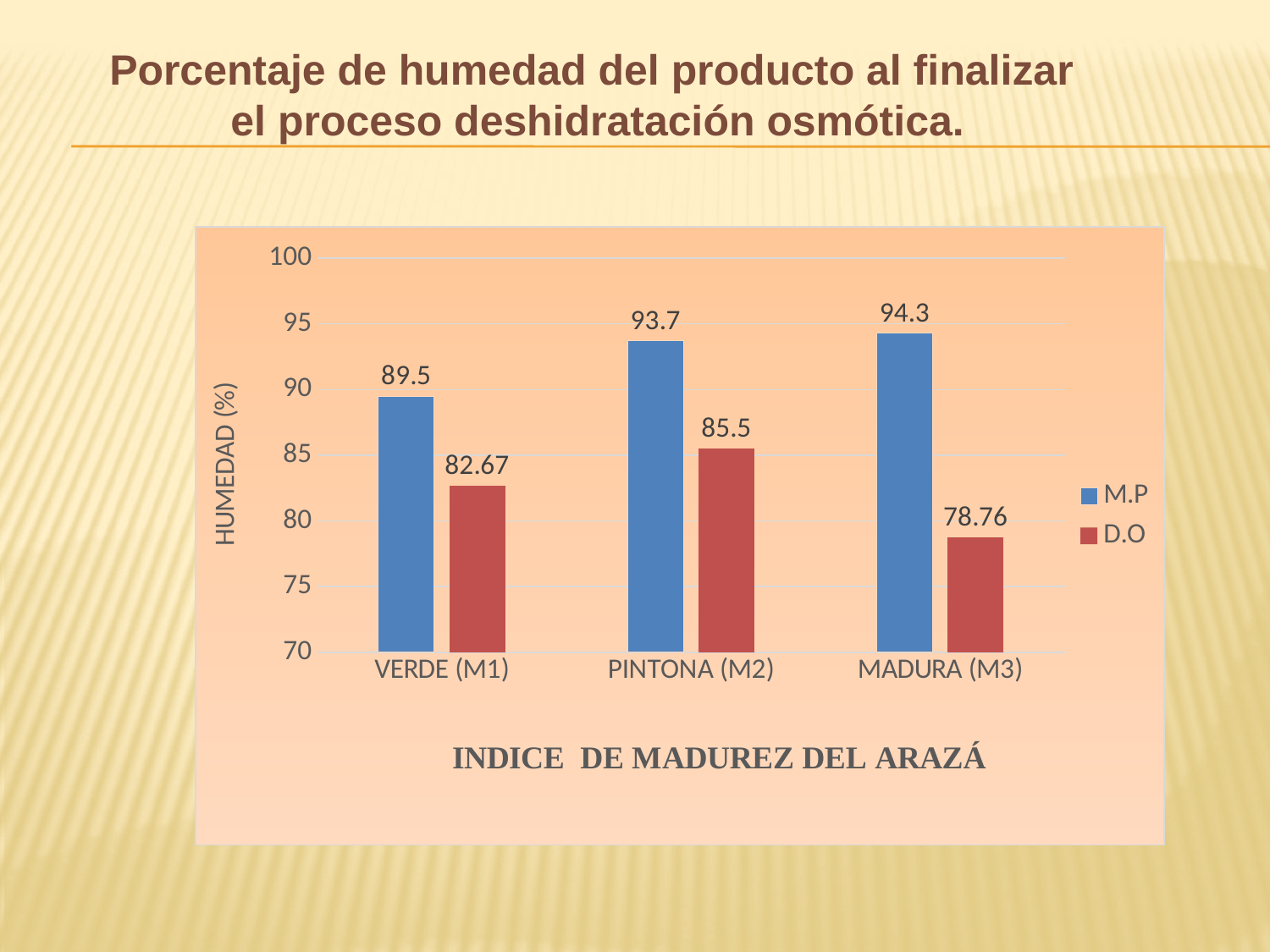
How many categories are shown on the x axis? 3 What is the D.O value for MADURA (M3)? 78.76 How many series does the legend list? 2 What is the difference between the M.P and D.O values for MADURA (M3)? 15.54 Which category has the highest M.P value? MADURA (M3) Which is larger, the D.O value for VERDE (M1) or the D.O value for PINTONA (M2)? PINTONA (M2) What is the difference between the M.P and D.O values for VERDE (M1)? 6.83 What is the label of the y axis? HUMEDAD (%) What kind of chart is shown on the slide? Bar chart Which category has the lowest D.O value? MADURA (M3) What is the D.O value for PINTONA (M2)? 85.5 What is the M.P value for VERDE (M1)? 89.5